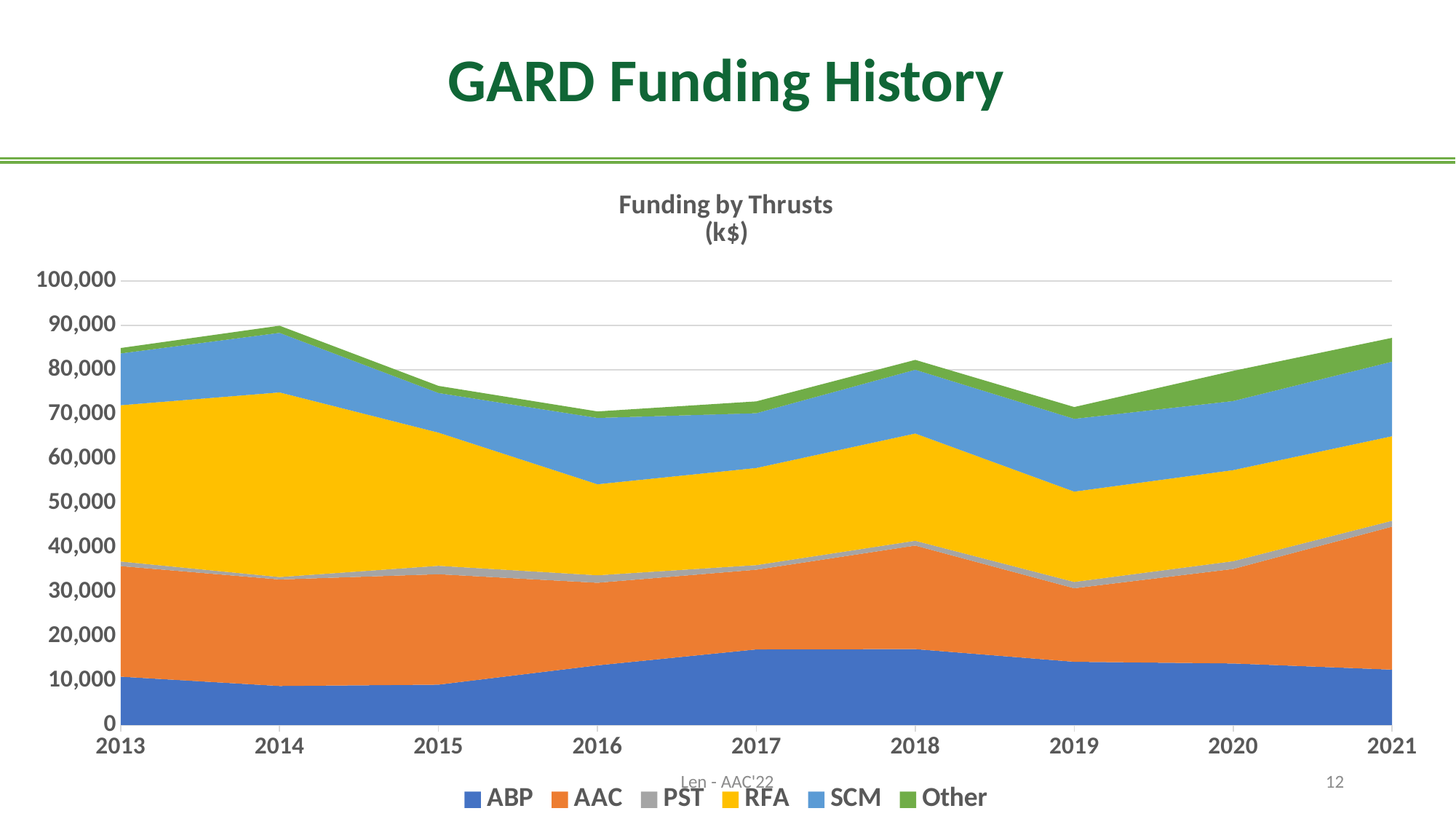
What kind of chart is shown on the slide? stacked area chart Does the total funding rise or fall from 2014 to 2016? fall How many series does the legend list? 6 Is the total funding in 2021 greater or less than 80,000? greater How many years are shown along the x axis? 9 Which colour represents the RFA series in the legend? yellow Which series has the largest funding in 2013? RFA Is the total funding in 2014 greater or less than 80,000? greater Which is larger, the ABP value in 2014 or the ABP value in 2017? 2017 Is the ABP value in 2017 greater or less than 10,000? greater What is the title of the chart? Funding by Thrusts (k$)